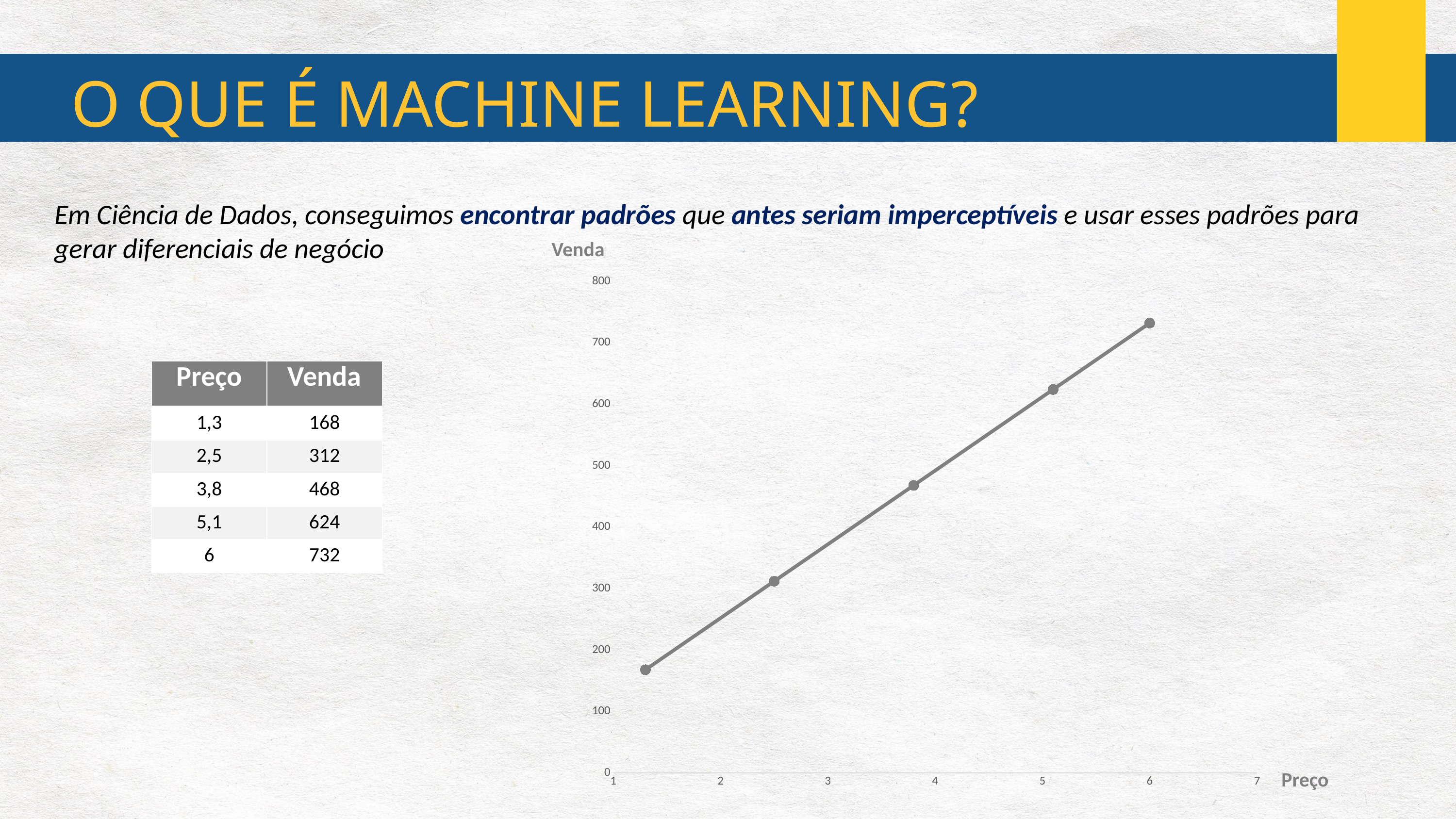
How many data points are plotted on the chart? 5 What is the label of the horizontal axis of the chart? Preço Which Preço value has the highest Venda? 6 Is the Venda value plotted at Preço 6 greater or less than 700? greater Do the Venda values rise or fall as Preço increases along the x axis? rise Is the Venda value plotted at Preço 1,3 greater or less than 200? less What kind of chart is shown on the slide? line chart According to the table on the slide, what is the Venda value when Preço is 3,8? 468 What is the label of the vertical axis of the chart? Venda Using the values in the table, what is the difference in Venda between Preço 6 and Preço 1,3? 564 According to the table on the slide, what is the Venda value when Preço is 6? 732 Which Preço value has the lowest Venda? 1,3